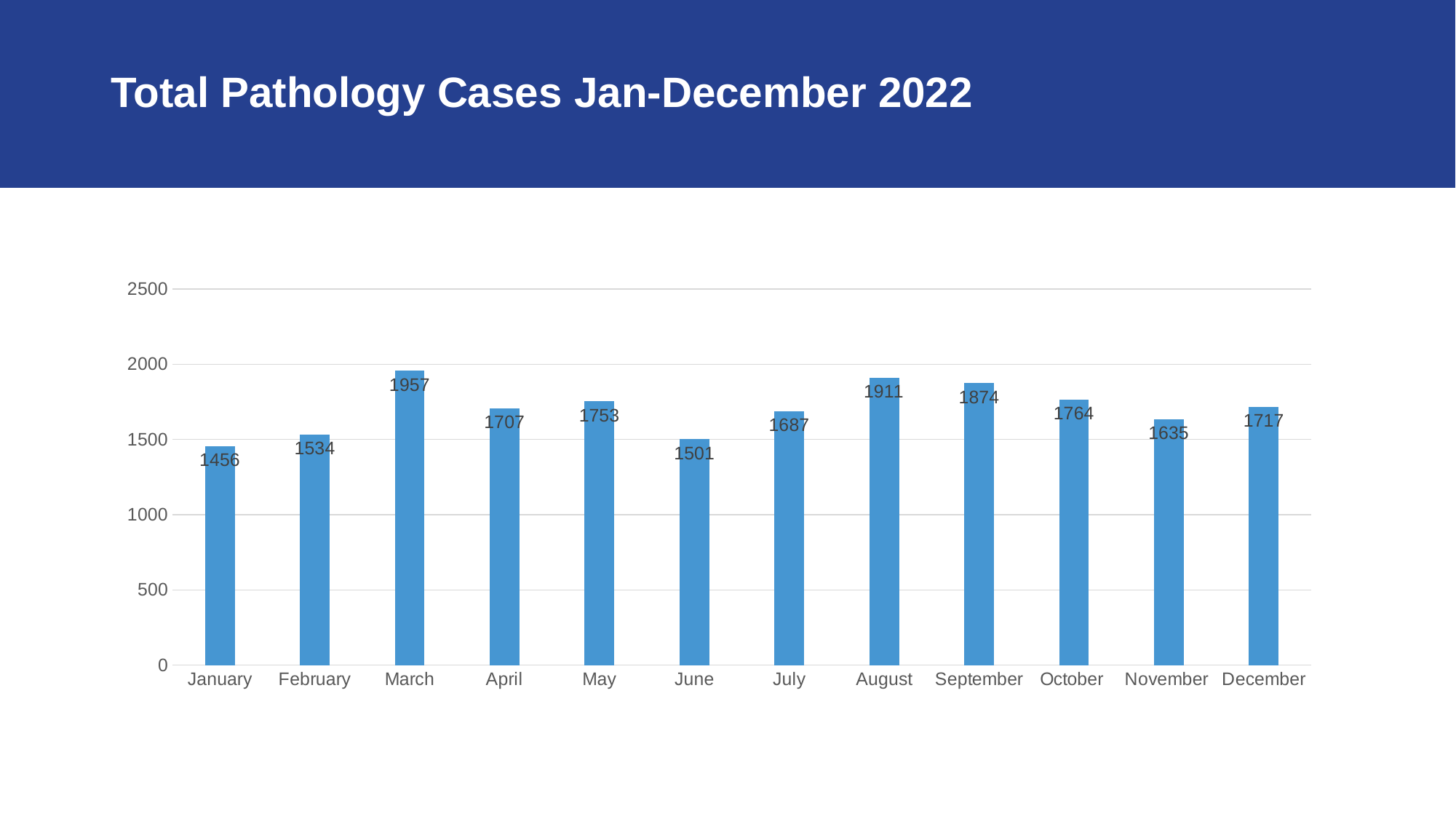
What is the difference between the values for August and September? 37 Which is larger, the value for May or the value for July? May What kind of chart is shown on the slide? bar chart What is the value for March? 1957 What is the value for June? 1501 Which month has the highest value? March How many months are shown on the x axis? 12 What is the difference between the values for March and January? 501 What is the value for October? 1764 What is the title of the slide? Total Pathology Cases Jan-December 2022 Is the value for November greater or less than 1500? greater Which month has the lowest value? January